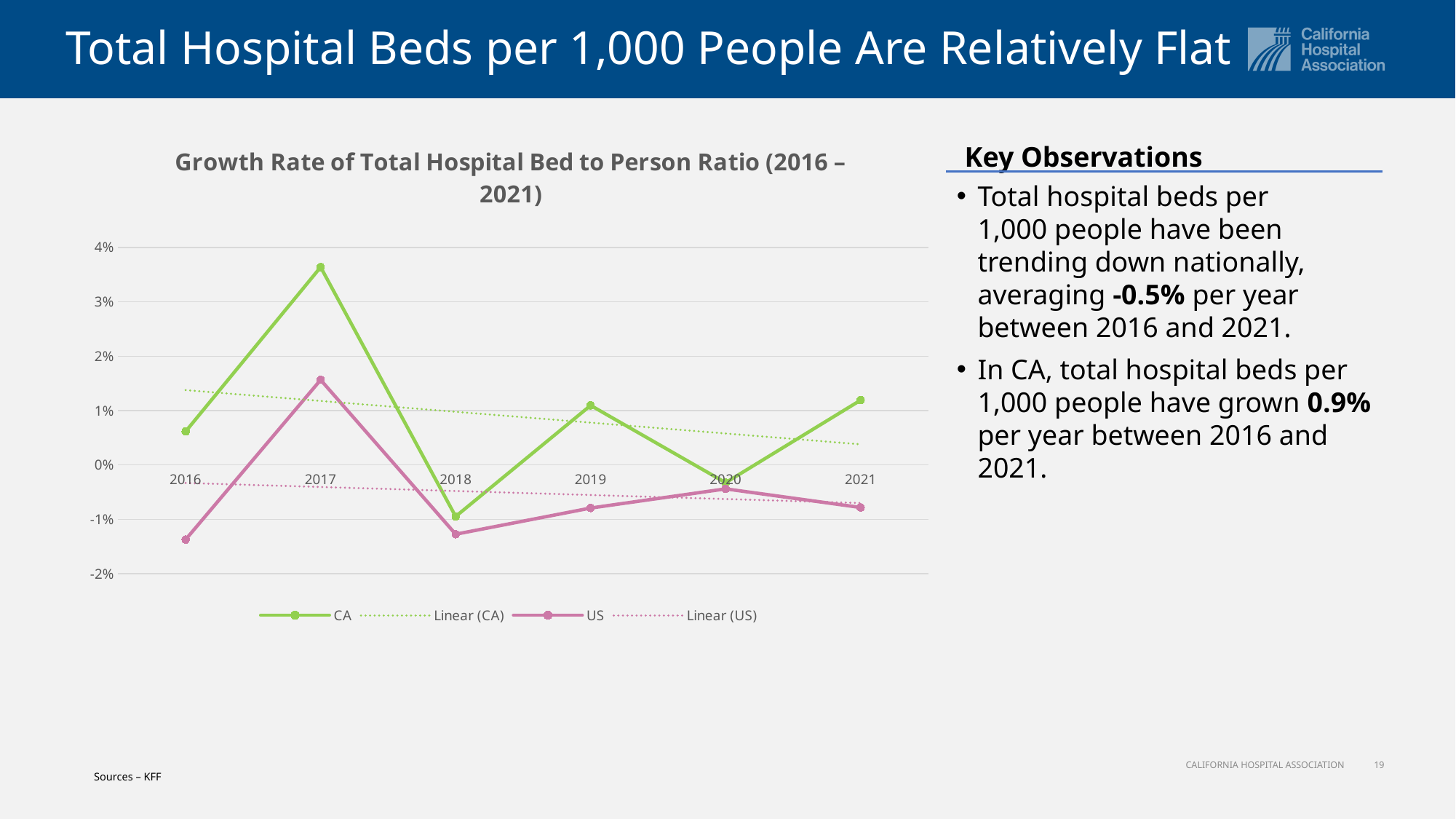
In which year does the US series reach its highest value? 2017 In which year does the CA series reach its lowest value? 2018 What is the title of the chart? Growth Rate of Total Hospital Bed to Person Ratio (2016 – 2021) In which year does the CA series reach its highest value? 2017 Is the CA value for 2017 greater or less than 3%? greater In 2017, which series has the larger value, CA or US? CA What kind of chart is shown on the slide? line chart In which year does the US series reach its lowest value? 2016 Is the US value for 2016 greater or less than -1%? less Does the Linear (CA) trendline rise or fall from 2016 to 2021? fall How many years are plotted along the x axis? 6 How many entries does the chart legend list? 4